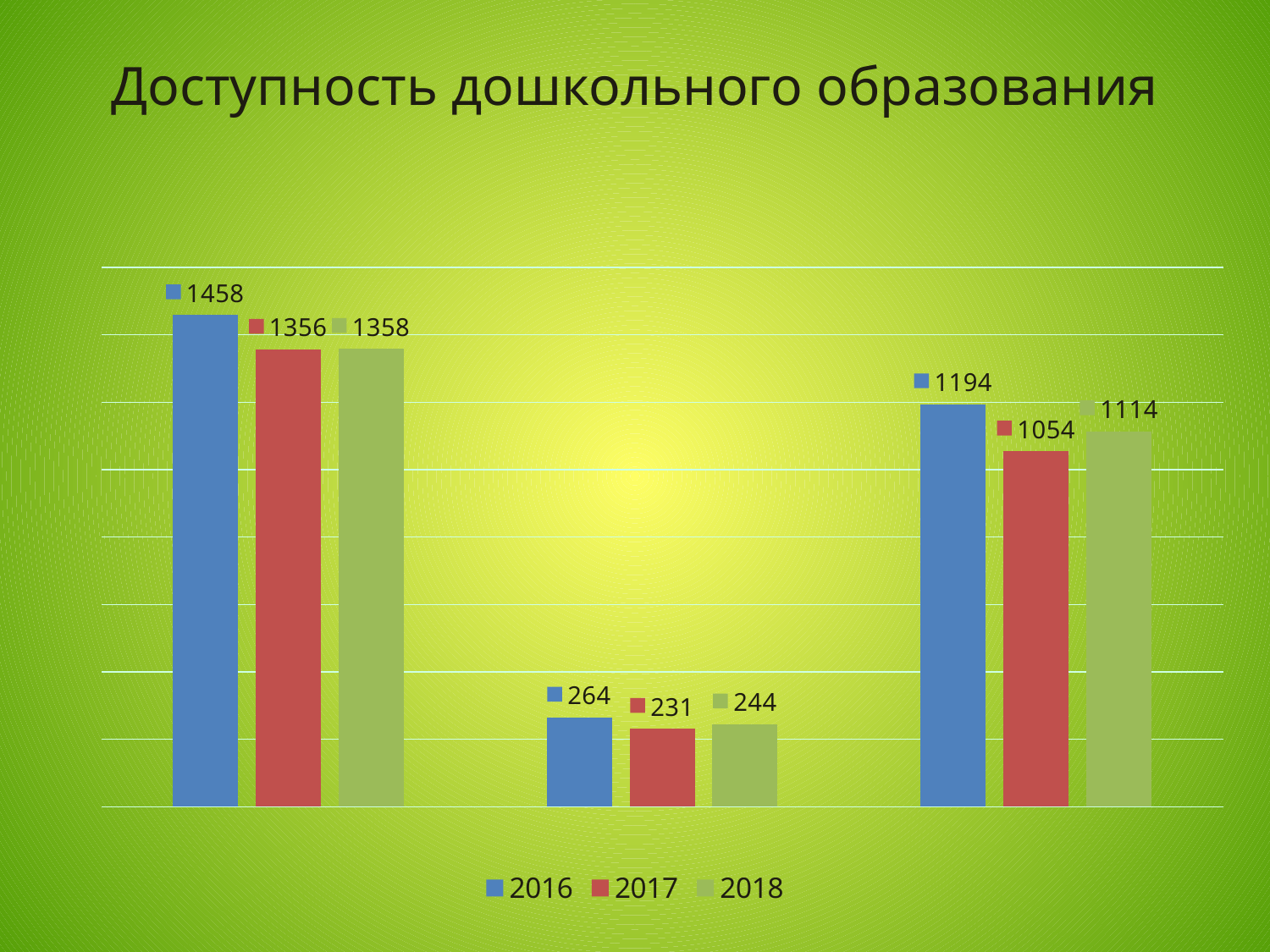
Which series has the highest value in the rightmost group? 2016 What is the value of the 2018 bar in the rightmost group? 1114 What is the value of the 2017 bar in the middle group? 231 What is the title of the chart on the slide? Доступность дошкольного образования How many groups of bars are plotted in the chart? 3 Which is larger in the rightmost group: the 2017 value or the 2018 value? 2018 What is the value of the 2016 bar in the leftmost group? 1458 Which series has the lowest value in the middle group? 2017 What kind of chart is shown on the slide? bar chart How many series does the legend list? 3 Which series is shown in red in the legend? 2017 What is the difference between the 2016 and 2017 values in the leftmost group? 102